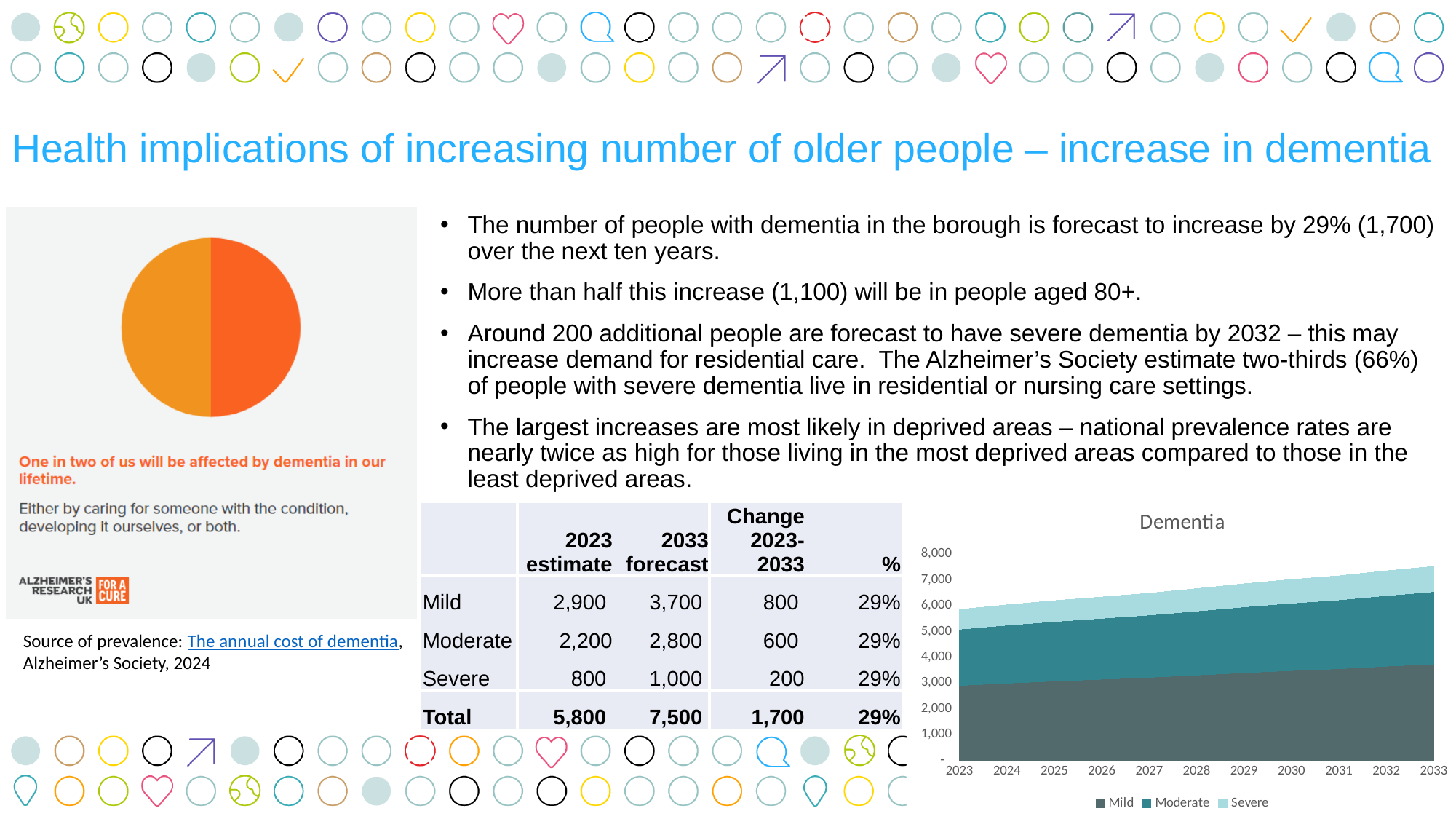
In the 'Dementia' chart, does the total number of people with dementia rise or fall from 2023 to 2033? Rise Which series are listed in the legend of the 'Dementia' chart? Mild, Moderate, Severe What is the highest value shown on the y axis of the 'Dementia' chart? 8,000 How many series does the legend of the 'Dementia' chart list? 3 How many years are shown on the x axis of the 'Dementia' chart? 11 In the 'Dementia' chart, is the total for 2033 greater or less than 7,000? greater In the 'Dementia' chart, which series is the smallest in 2033? Severe In the 'Dementia' chart, is the Mild value for 2023 greater or less than 3,000? less In the 'Dementia' chart, is the total for 2023 greater or less than 6,000? less What kind of chart is the 'Dementia' chart on the slide? Stacked area chart In the 'Dementia' chart, which series is the largest in 2023: Mild or Severe? Mild What is the first year shown on the x axis of the 'Dementia' chart? 2023